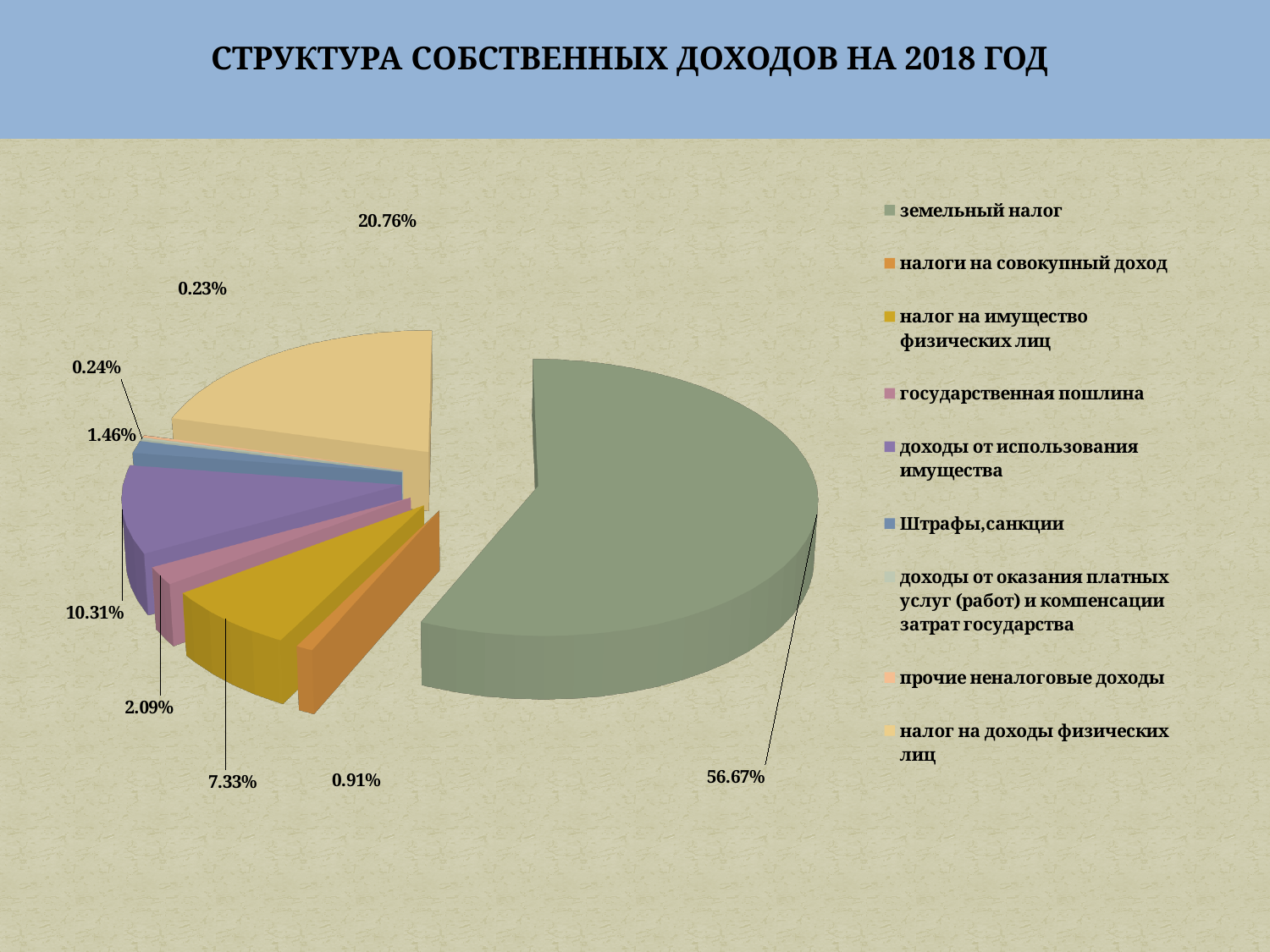
What share of the pie does налог на доходы физических лиц have? 20.76% Which category has the largest share of the pie? земельный налог What share of the pie does налоги на совокупный доход have? 0.91% What share of the pie does земельный налог have? 56.67% What share of the pie does доходы от использования имущества have? 10.31% What share of the pie does Штрафы,санкции have? 1.46% What share of the pie does государственная пошлина have? 2.09% What is the title of the chart? СТРУКТУРА СОБСТВЕННЫХ ДОХОДОВ НА 2018 ГОД What is the difference between the shares of земельный налог and налог на доходы физических лиц? 35.91% What kind of chart is shown on the slide? pie chart How many categories does the legend list? 9 What share of the pie does налог на имущество физических лиц have? 7.33%